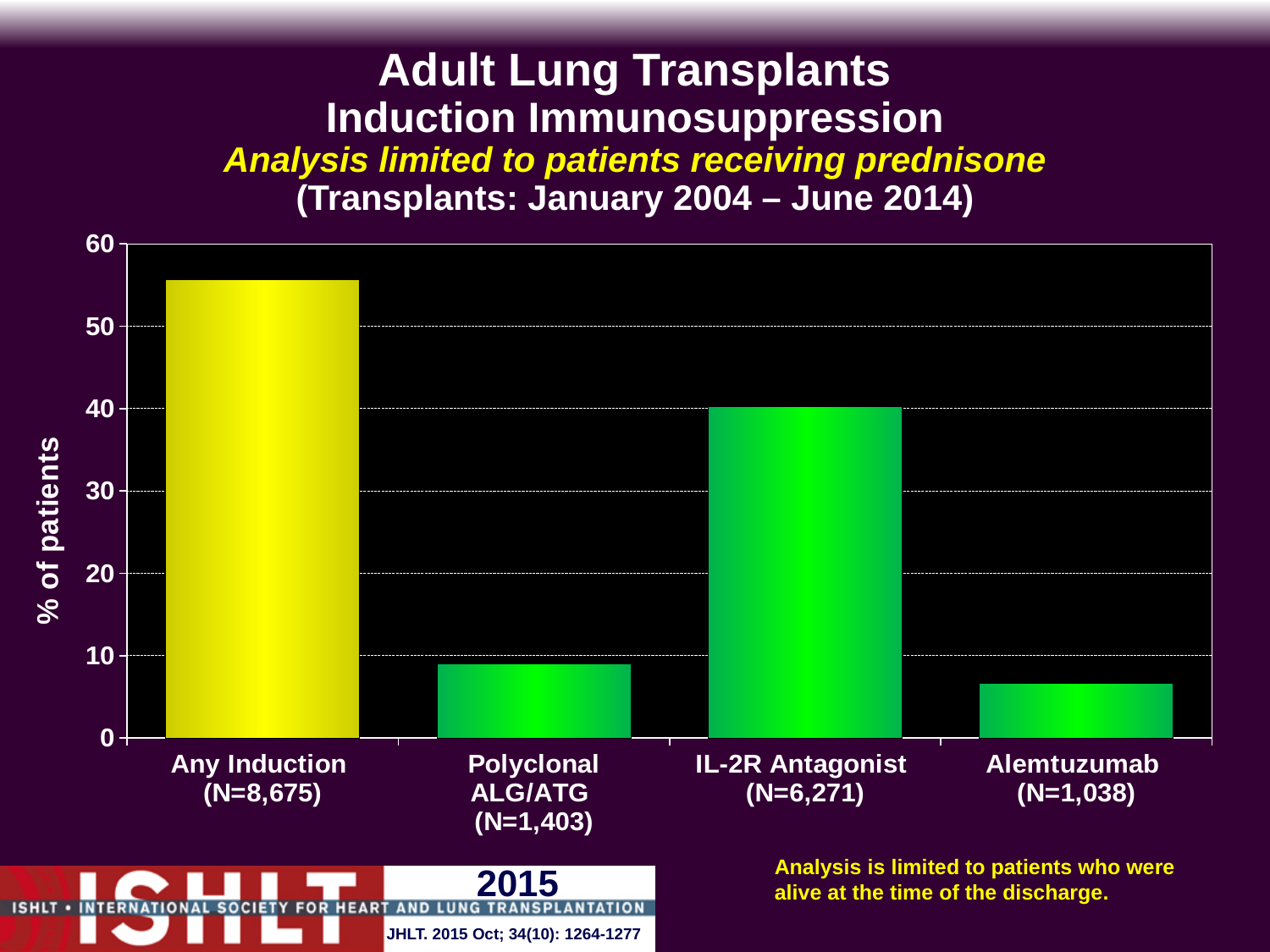
What is the label of the y axis of the chart? % of patients What kind of chart is shown on the slide? Bar chart Which is larger, the value for IL-2R Antagonist or the value for Any Induction? Any Induction How many categories are shown on the x axis of the chart? 4 Is the value for Any Induction greater or less than 50? greater Is the value for Alemtuzumab greater or less than 10? less Is the value for IL-2R Antagonist greater or less than 30? greater Which category has the highest percentage of patients? Any Induction Which is larger, the value for Polyclonal ALG/ATG or the value for Alemtuzumab? Polyclonal ALG/ATG What is the N shown for the IL-2R Antagonist category? N=6,271 Which category has the lowest percentage of patients? Alemtuzumab